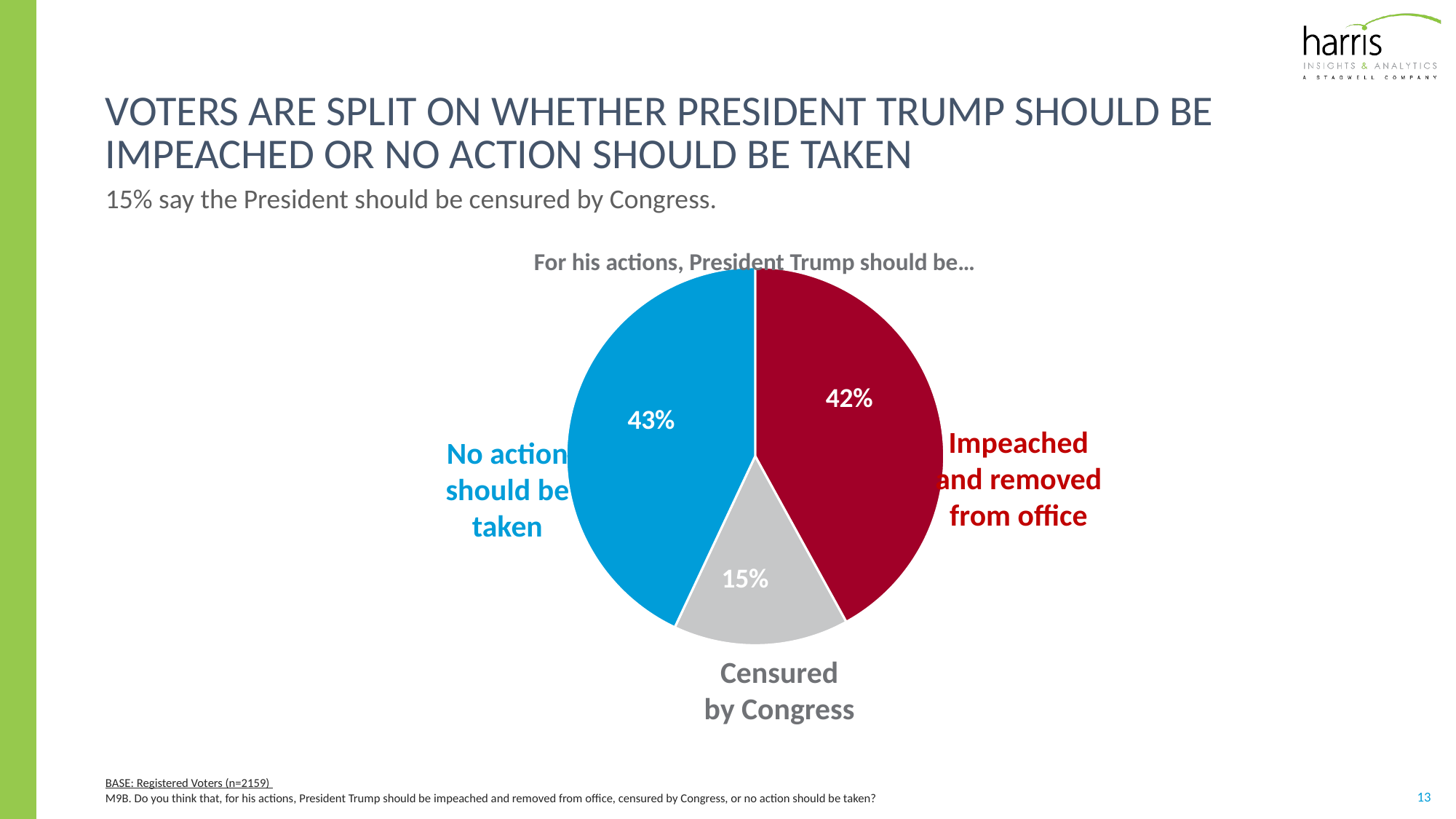
Which is larger: the share for 'Impeached and removed from office' or the share for 'Censured by Congress'? Impeached and removed from office What is the difference in percentage points between 'Impeached and removed from office' and 'Censured by Congress'? 27 How many slices does the pie chart have? 3 What type of chart is shown on the slide? Pie chart What percentage of voters say President Trump should be censured by Congress? 15% What percentage of voters say no action should be taken? 43% What percentage of voters say President Trump should be impeached and removed from office? 42% What colour is the slice for 'No action should be taken'? Blue What is the title of the chart? For his actions, President Trump should be… Which response has the largest share of the pie? No action should be taken Which response has the smallest share of the pie? Censured by Congress What is the difference in percentage points between 'No action should be taken' and 'Censured by Congress'? 28